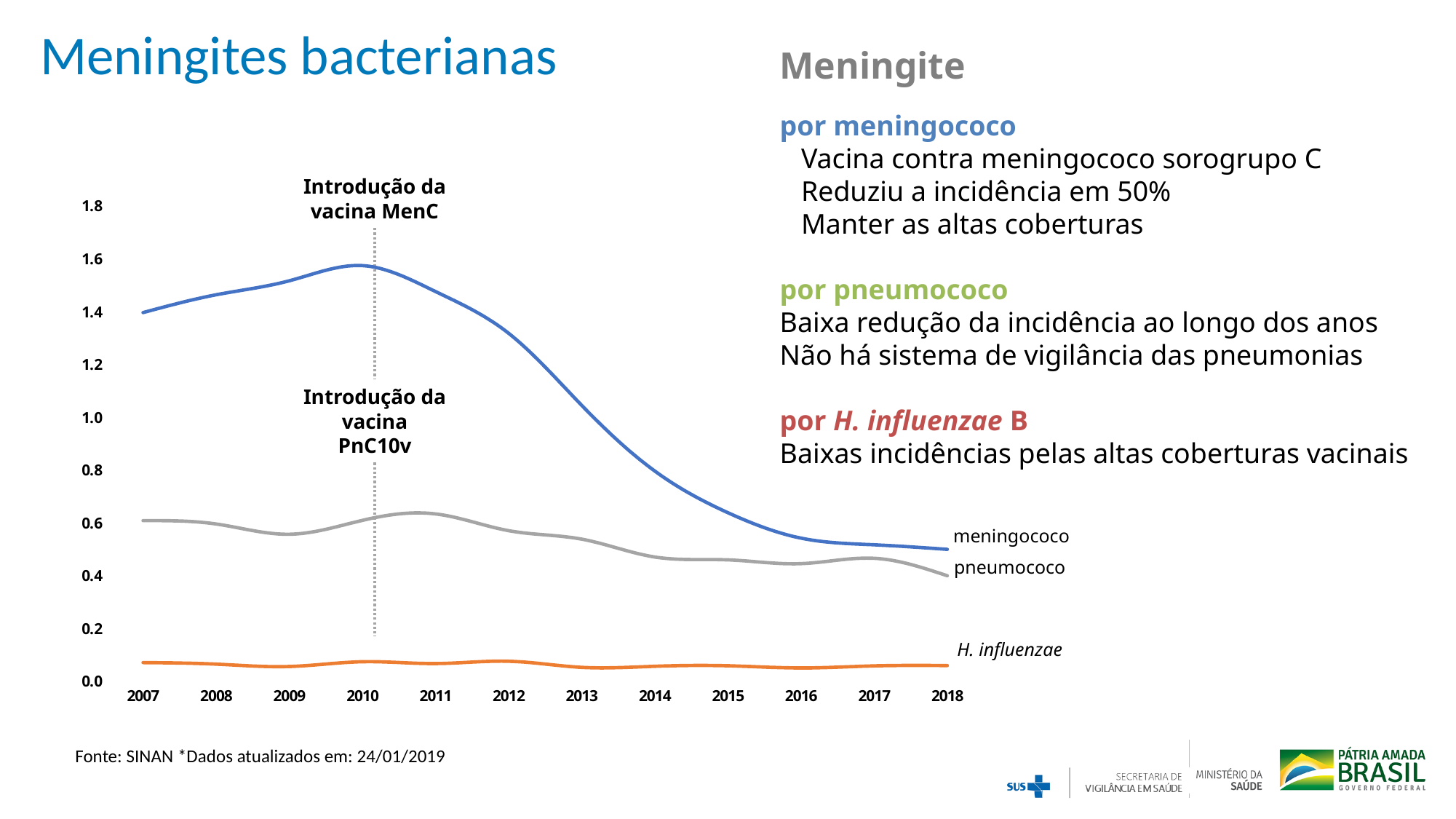
Is the value for pneumococo in 2007 greater or less than 0.4? greater Is the value for meningococo in 2007 greater or less than 1.2? greater How many series are plotted on the chart? 3 In which year does the meningococo line reach its peak? 2010 Which is larger in 2012, the value for meningococo or the value for pneumococo? meningococo How many years are shown along the x axis of the chart? 12 Is the value for meningococo in 2018 greater or less than 0.6? less What kind of chart is shown on the slide? line chart Does the meningococo line rise or fall between 2010 and 2018? fall In which year does the dotted vertical line marking the introduction of the MenC and PnC10v vaccines appear? 2010 Which series has the highest value in 2007? meningococo Which series has the lowest values across all years? H. influenzae